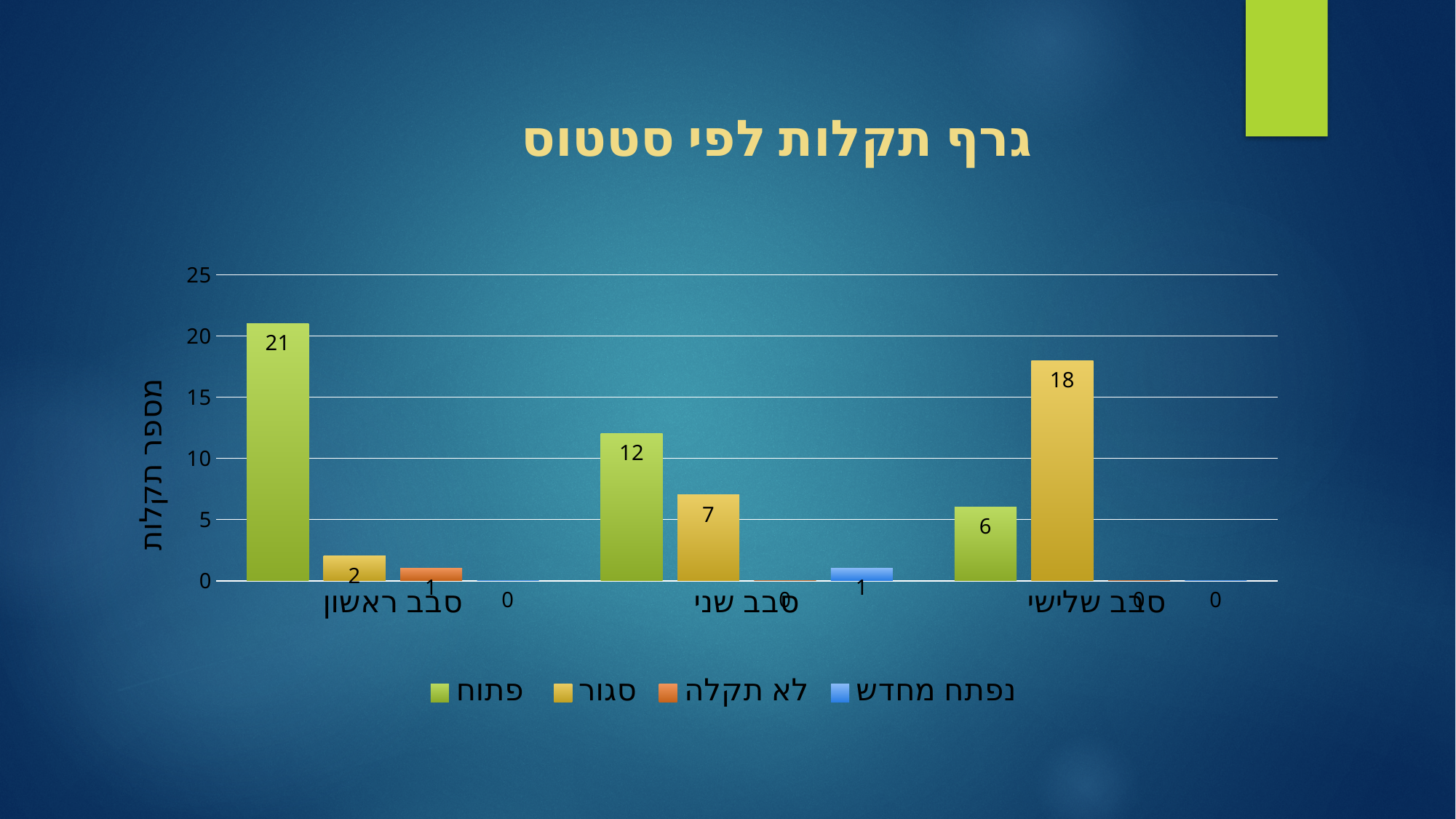
For סבב שלישי, which is larger: the פתוח value or the סגור value? סגור Which category has the lowest value for the פתוח series? סבב שלישי What is the value of the סגור series for סבב שני? 7 How many series does the legend list? 4 What is the value of the נפתח מחדש series for סבב שני? 1 What is the difference between the פתוח values for סבב ראשון and סבב שני? 9 What kind of chart is shown on the slide? Bar chart Which category has the highest value for the פתוח series? סבב ראשון What is the title of the chart? גרף תקלות לפי סטטוס What is the value of the פתוח series for סבב ראשון? 21 What is the value of the סגור series for סבב שלישי? 18 How many categories are shown on the x axis? 3